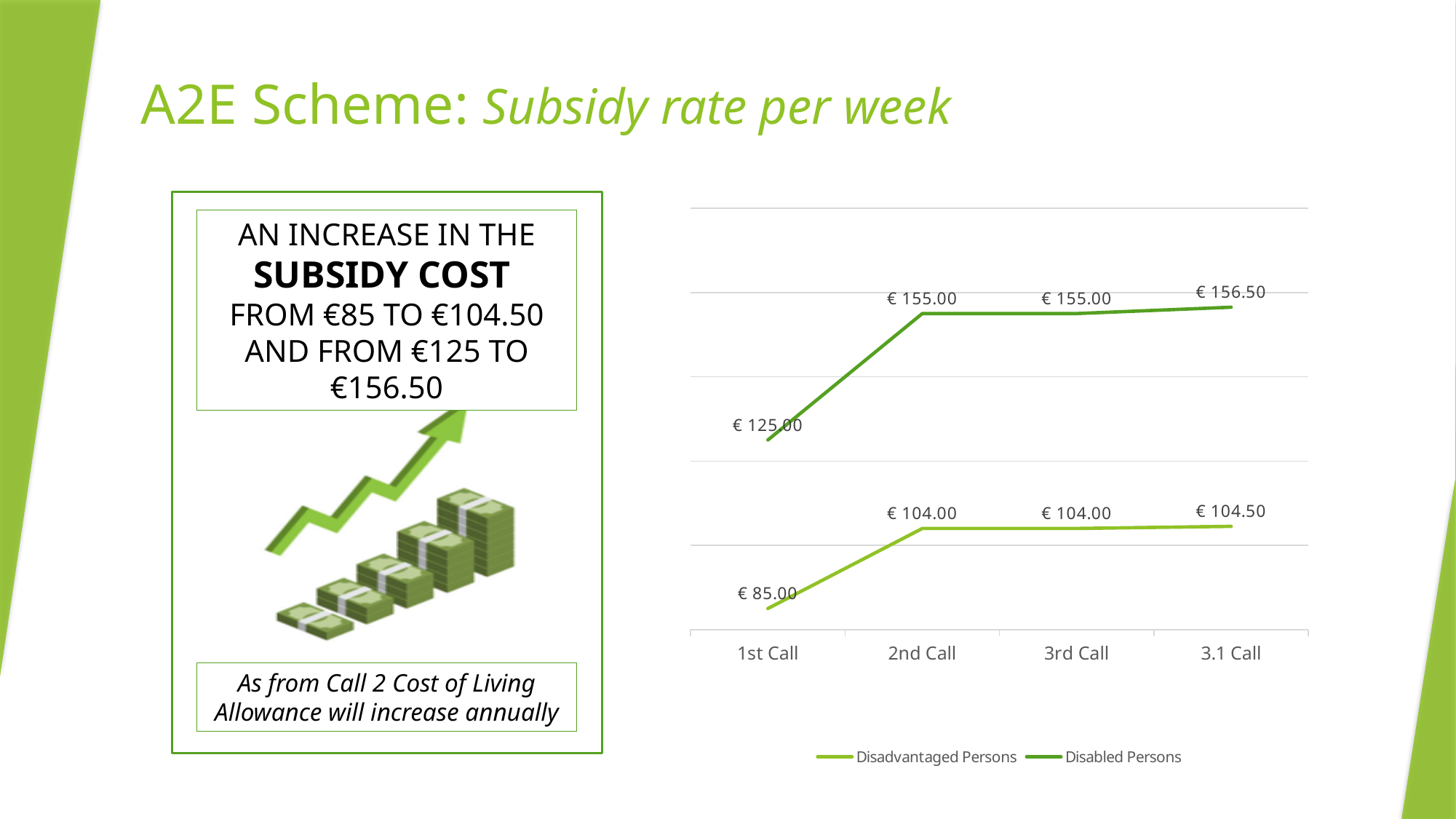
What is the value for Disadvantaged Persons at the 3.1 Call? € 104.50 What kind of chart is shown on the slide? Line chart At which call is the value for Disadvantaged Persons lowest? 1st Call What is the difference between the Disabled Persons and Disadvantaged Persons values at the 3.1 Call? € 52.00 What is the value for Disadvantaged Persons at the 2nd Call? € 104.00 Which is larger at the 1st Call: the value for Disabled Persons or for Disadvantaged Persons? Disabled Persons How many calls are shown on the x axis? 4 What is the difference between the Disabled Persons value at the 2nd Call and at the 1st Call? € 30.00 What is the value for Disabled Persons at the 3rd Call? € 155.00 What is the value for Disabled Persons at the 1st Call? € 125.00 How many series does the legend list? 2 At which call is the value for Disabled Persons highest? 3.1 Call